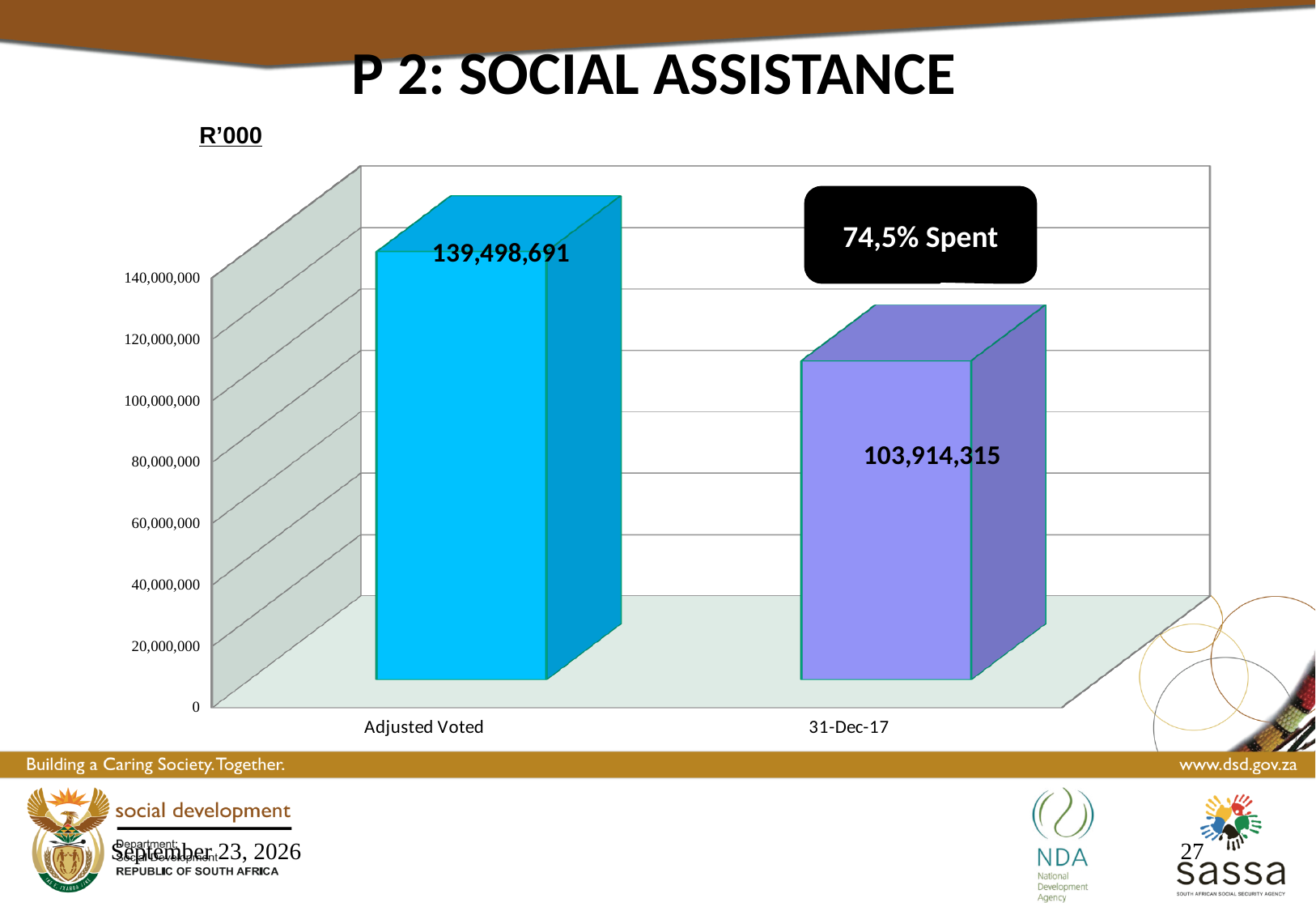
Which is larger, the value for Adjusted Voted or the value for 31-Dec-17? Adjusted Voted Do the values rise or fall from Adjusted Voted to 31-Dec-17? fall Is the value for Adjusted Voted greater or less than 120,000,000? greater How many categories are shown on the x axis of the chart? 2 Which category has the lowest value? 31-Dec-17 What is the value for 31-Dec-17? 103,914,315 What kind of chart is shown on the slide? bar chart What is the difference between the Adjusted Voted value and the 31-Dec-17 value? 35,584,376 Which category has the highest value? Adjusted Voted Is the value for 31-Dec-17 greater or less than 120,000,000? less What percentage spent is shown in the black box on the chart? 74,5% Spent What is the value for Adjusted Voted? 139,498,691